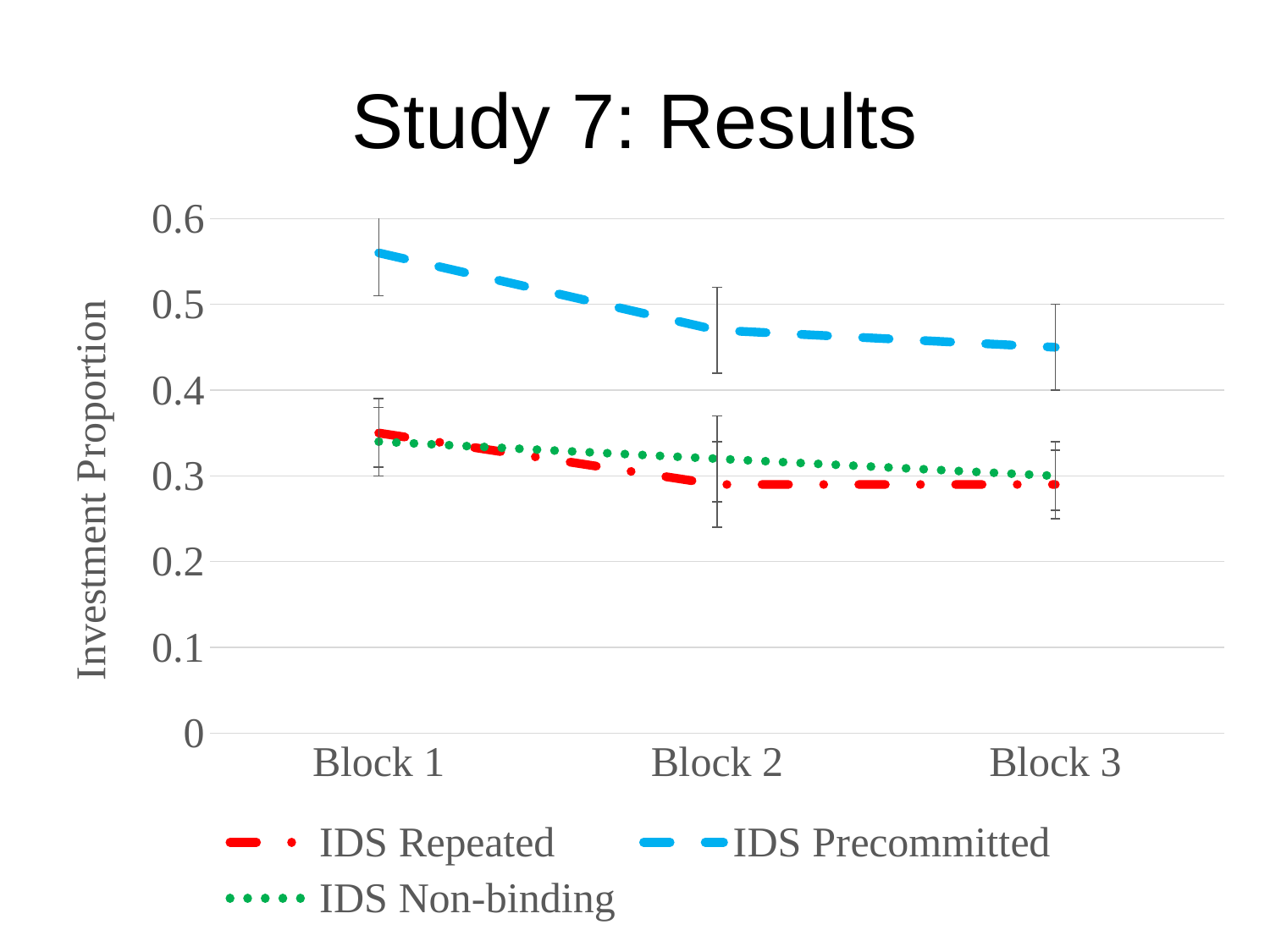
What kind of chart is shown on the slide? line chart Does the IDS Precommitted line rise or fall from Block 1 to Block 3? fall Is the value for IDS Repeated at Block 1 greater or less than 0.3? greater Is the value for IDS Precommitted at Block 1 greater or less than 0.5? greater Which series has the highest investment proportion at Block 1? IDS Precommitted Is the value for IDS Precommitted at Block 2 greater or less than 0.5? less Which series has the lowest investment proportion at Block 3? IDS Repeated What is the label on the y axis? Investment Proportion How many blocks are shown on the x axis? 3 How many series does the legend list? 3 Which is larger at Block 3: IDS Precommitted or IDS Repeated? IDS Precommitted